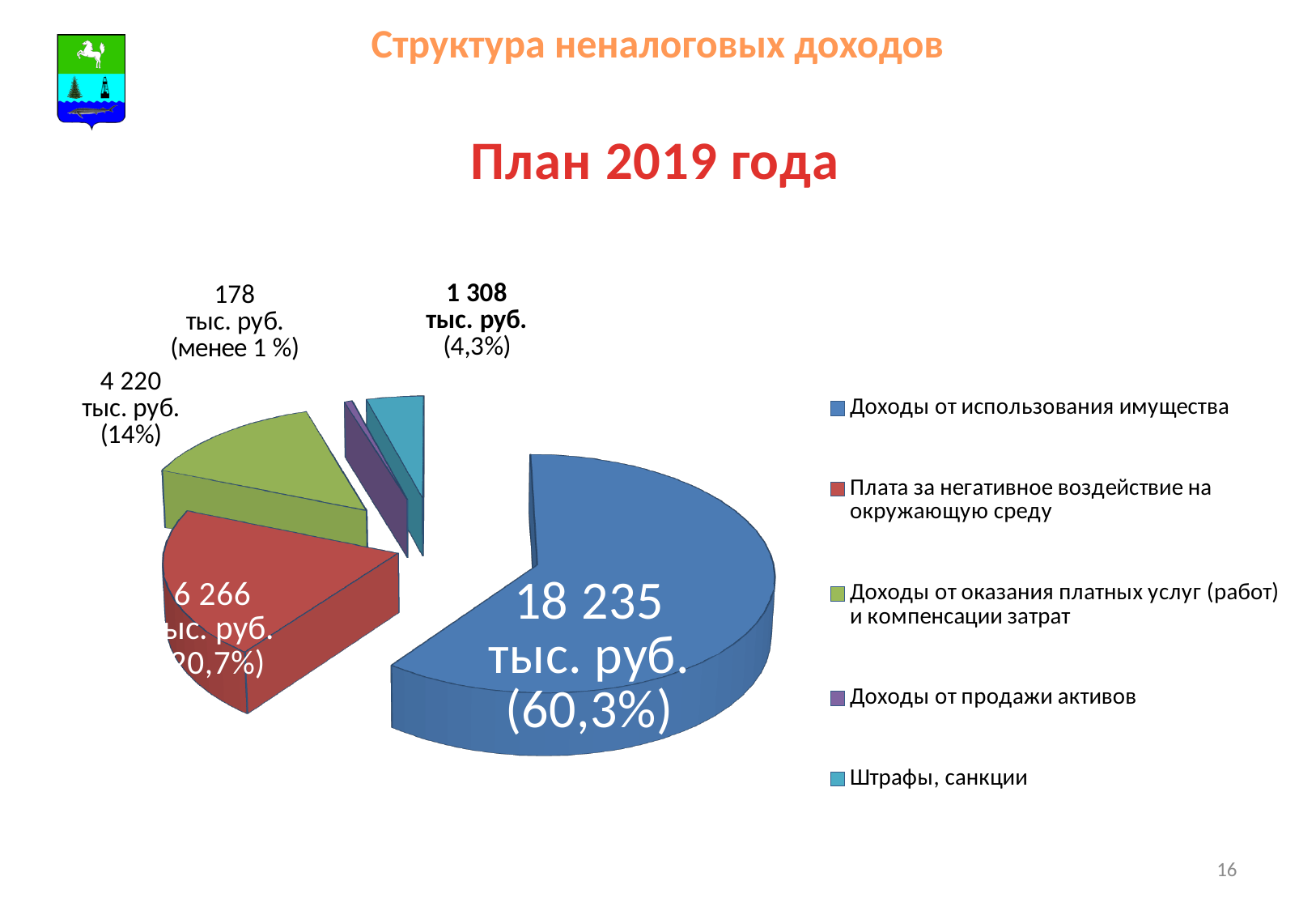
What share of the pie does Доходы от использования имущества take? 60,3% What share of the pie does Штрафы, санкции take? 4,3% How many entries does the legend list? 5 How many slices does the pie chart have? 5 What is the value for Доходы от оказания платных услуг (работ) и компенсации затрат? 4 220 тыс. руб. What is the value for Плата за негативное воздействие на окружающую среду? 6 266 тыс. руб. Which is larger: Доходы от оказания платных услуг (работ) и компенсации затрат or Штрафы, санкции? Доходы от оказания платных услуг (работ) и компенсации затрат Which category has the smallest slice? Доходы от продажи активов What is the difference between Доходы от использования имущества and Плата за негативное воздействие на окружающую среду? 11 969 тыс. руб. What is the value for Доходы от использования имущества? 18 235 тыс. руб. Which category has the largest slice? Доходы от использования имущества What kind of chart is shown on the slide? Pie chart